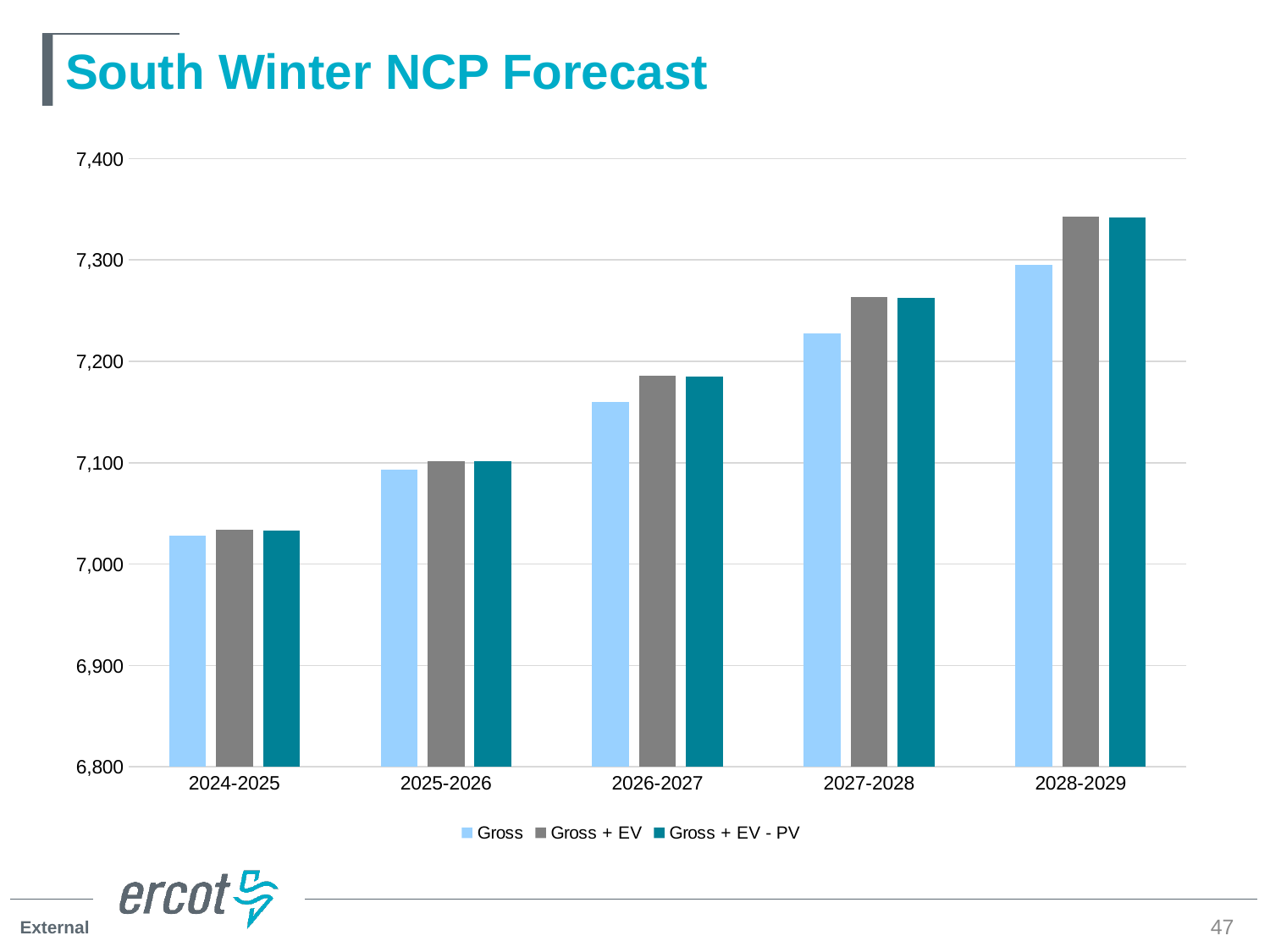
Is the Gross + EV value for 2028-2029 greater or less than 7,300? greater What is the title of the chart? South Winter NCP Forecast In 2028-2029, which is larger: Gross or Gross + EV? Gross + EV What kind of chart is shown on the slide? bar chart How many series does the legend list? 3 How many winter seasons are shown on the x axis? 5 Is the Gross value for 2026-2027 greater or less than 7,200? less Is the Gross value for 2024-2025 greater or less than 7,000? greater Which season has the highest Gross value? 2028-2029 Which season has the lowest Gross + EV value? 2024-2025 Do the Gross values rise or fall from 2024-2025 to 2028-2029? rise